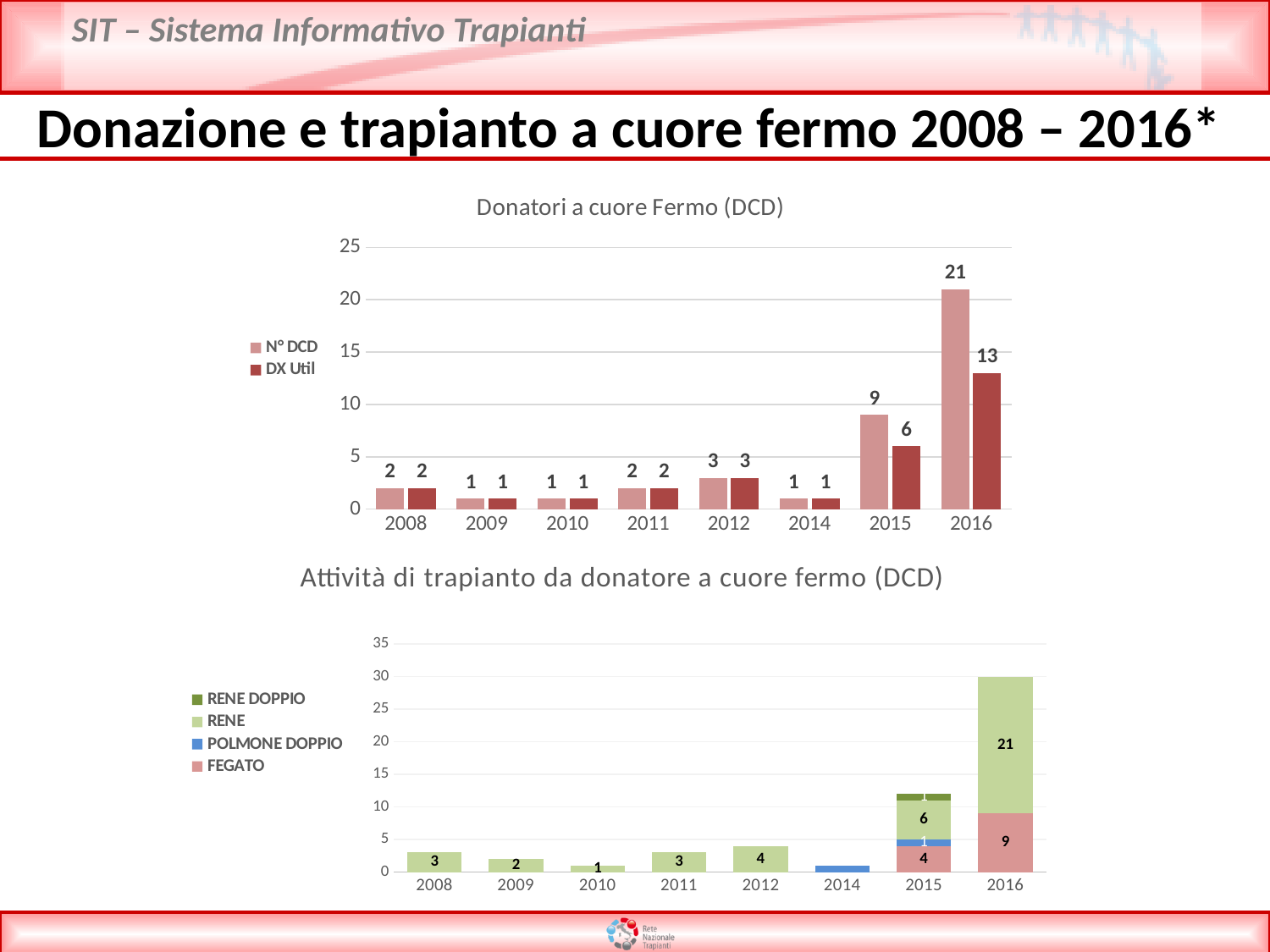
In the chart 'Attività di trapianto da donatore a cuore fermo (DCD)', what is the total of the stacked bar for 2016? 30 In the chart 'Donatori a cuore Fermo (DCD)', is the N° DCD value for 2016 greater or less than 20? greater In the chart 'Donatori a cuore Fermo (DCD)', how many years are shown on the x axis? 8 In the chart 'Donatori a cuore Fermo (DCD)', what is the DX Util value for 2015? 6 In the chart 'Attività di trapianto da donatore a cuore fermo (DCD)', how many series does the legend list? 4 In the chart 'Donatori a cuore Fermo (DCD)', what is the N° DCD value for 2016? 21 In the chart 'Attività di trapianto da donatore a cuore fermo (DCD)', what is the RENE value for 2016? 21 In the chart 'Donatori a cuore Fermo (DCD)', what is the difference between N° DCD and DX Util in 2016? 8 In the chart 'Donatori a cuore Fermo (DCD)', how many series does the legend list? 2 In the chart 'Attività di trapianto da donatore a cuore fermo (DCD)', what is the FEGATO value for 2015? 4 What type of chart is 'Attività di trapianto da donatore a cuore fermo (DCD)'? Stacked bar chart In the chart 'Donatori a cuore Fermo (DCD)', which year has the highest N° DCD value? 2016